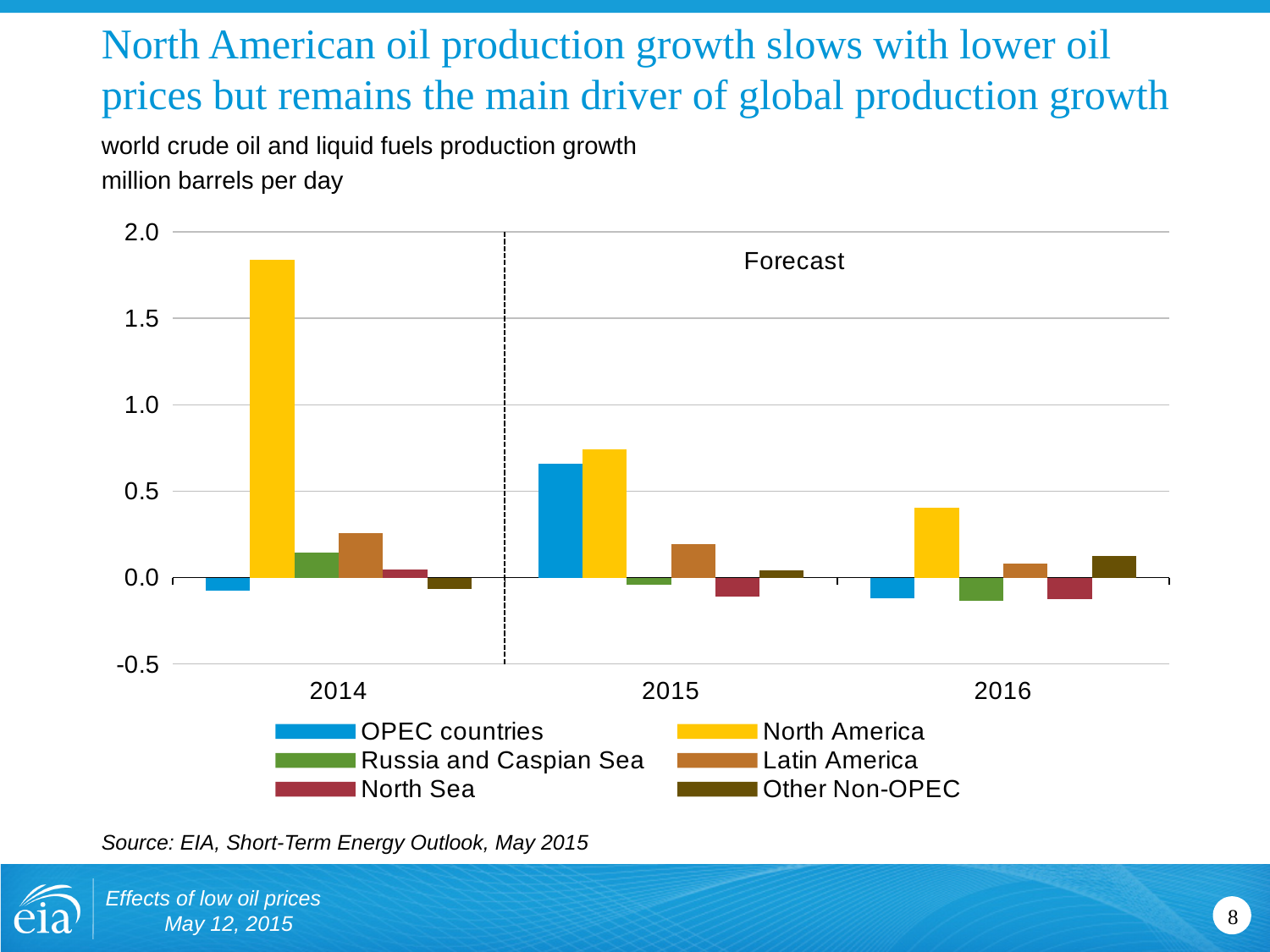
Is the value for OPEC countries in 2015 greater or less than 0.5? greater What unit is the y axis measured in? million barrels per day Is the value for North America in 2016 greater or less than 0.5? less Which region has the highest production growth in 2014? North America Is the value for North America in 2014 greater or less than 1.5? greater How many years are shown on the x axis? 3 How many series does the legend list? 6 Does North America's production growth rise or fall from 2014 to 2016? fall Which is larger, North America's production growth in 2014 or in 2015? 2014 What kind of chart is shown on the slide? bar chart Which region has the lowest production growth in 2015? North Sea